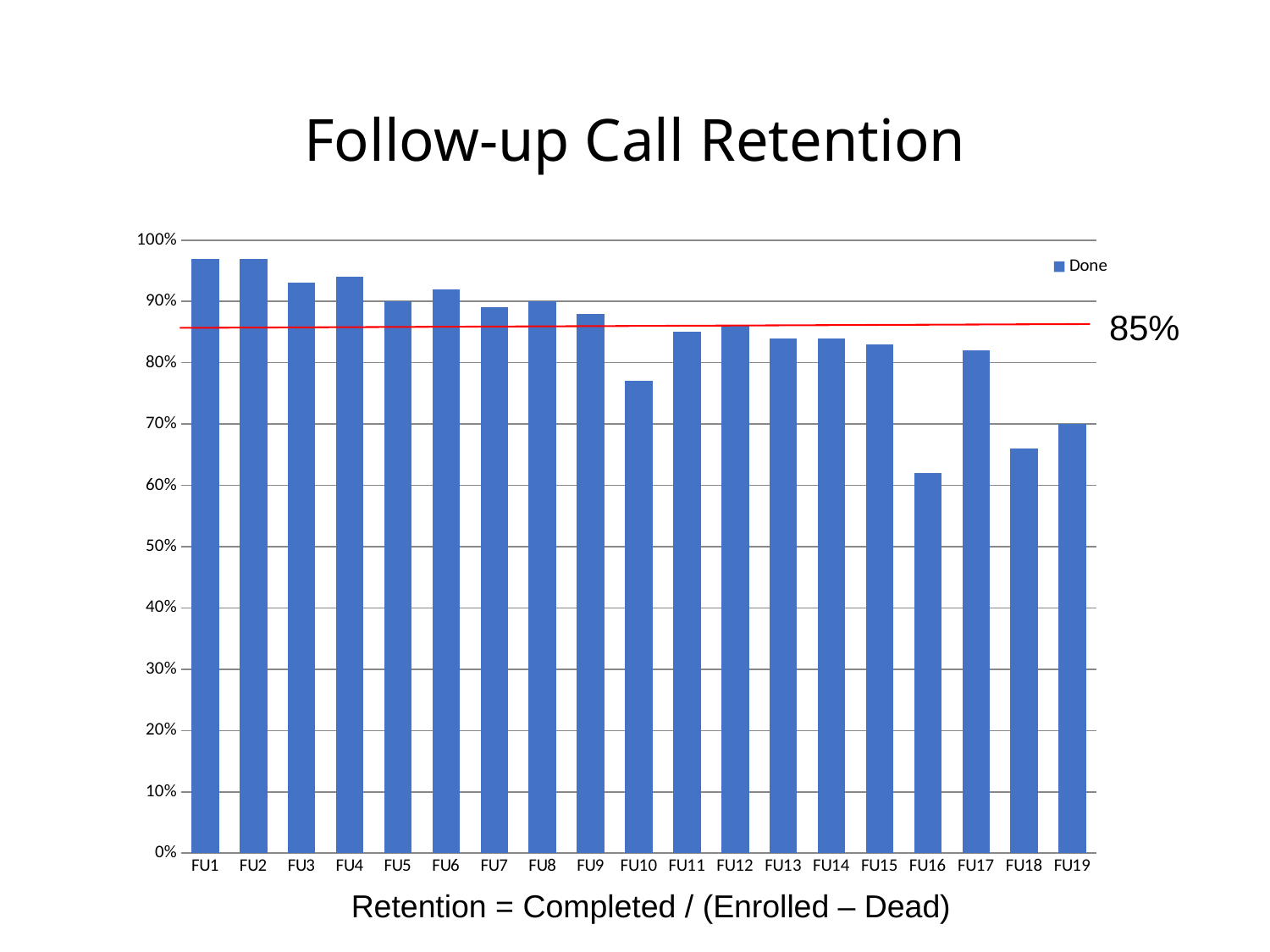
Is the retention value for FU1 greater or less than 90%? greater What value is labelled on the red horizontal reference line? 85% How many follow-up call categories are shown on the x axis? 19 Is the retention value for FU16 greater or less than 70%? less Which has the higher retention, FU17 or FU18? FU17 Is the retention value for FU10 greater or less than 80%? less Which follow-up call has the lowest retention? FU16 Do the retention values generally rise or fall from FU1 to FU19? fall What kind of chart is shown on the slide? bar chart How many series does the legend list? 1 Which has the higher retention, FU10 or FU11? FU11